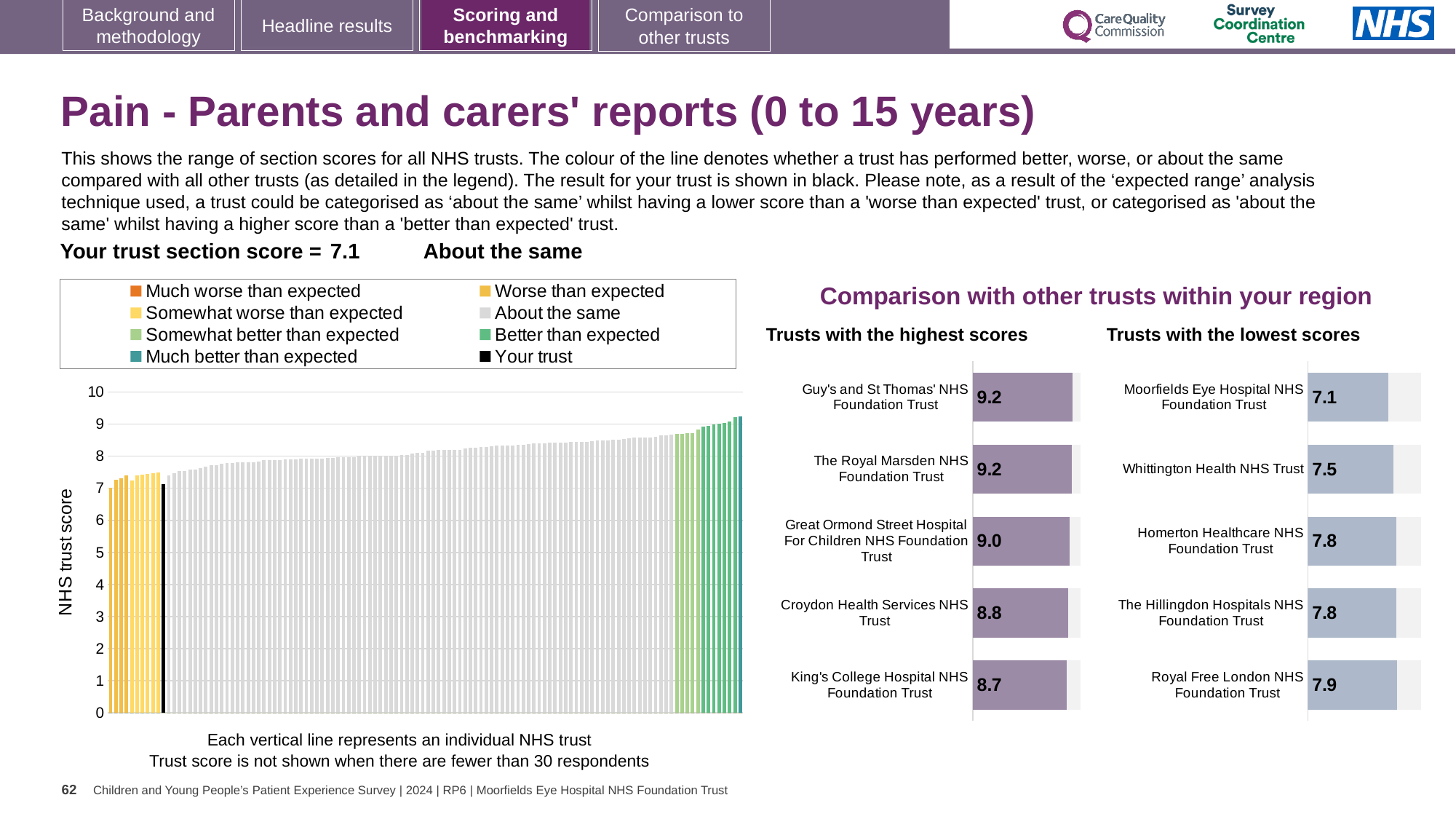
How many entries does the legend of the main chart on the left list? 8 In the 'Trusts with the lowest scores' chart, what is the score for Whittington Health NHS Trust? 7.5 How many trusts are shown in the 'Trusts with the lowest scores' chart? 5 In the main chart on the left, do the trust scores rise or fall from left to right along the x axis? rise In the 'Trusts with the lowest scores' chart, which trust has the highest score? Royal Free London NHS Foundation Trust In the 'Trusts with the highest scores' chart, what is the difference between the score for Guy's and St Thomas' NHS Foundation Trust and the score for King's College Hospital NHS Foundation Trust? 0.5 Which is larger: the score for Croydon Health Services NHS Trust in the 'Trusts with the highest scores' chart or the score for Whittington Health NHS Trust in the 'Trusts with the lowest scores' chart? Croydon Health Services NHS Trust In the 'Trusts with the lowest scores' chart, what is the difference between the score for Royal Free London NHS Foundation Trust and the score for Moorfields Eye Hospital NHS Foundation Trust? 0.8 In the main chart on the left, is the value for the black 'Your trust' bar greater or less than 8? less What kind of chart is the main chart on the left showing the range of section scores? bar chart In the 'Trusts with the highest scores' chart, which trust has the lowest score? King's College Hospital NHS Foundation Trust In the 'Trusts with the highest scores' chart, what is the score for Great Ormond Street Hospital For Children NHS Foundation Trust? 9.0